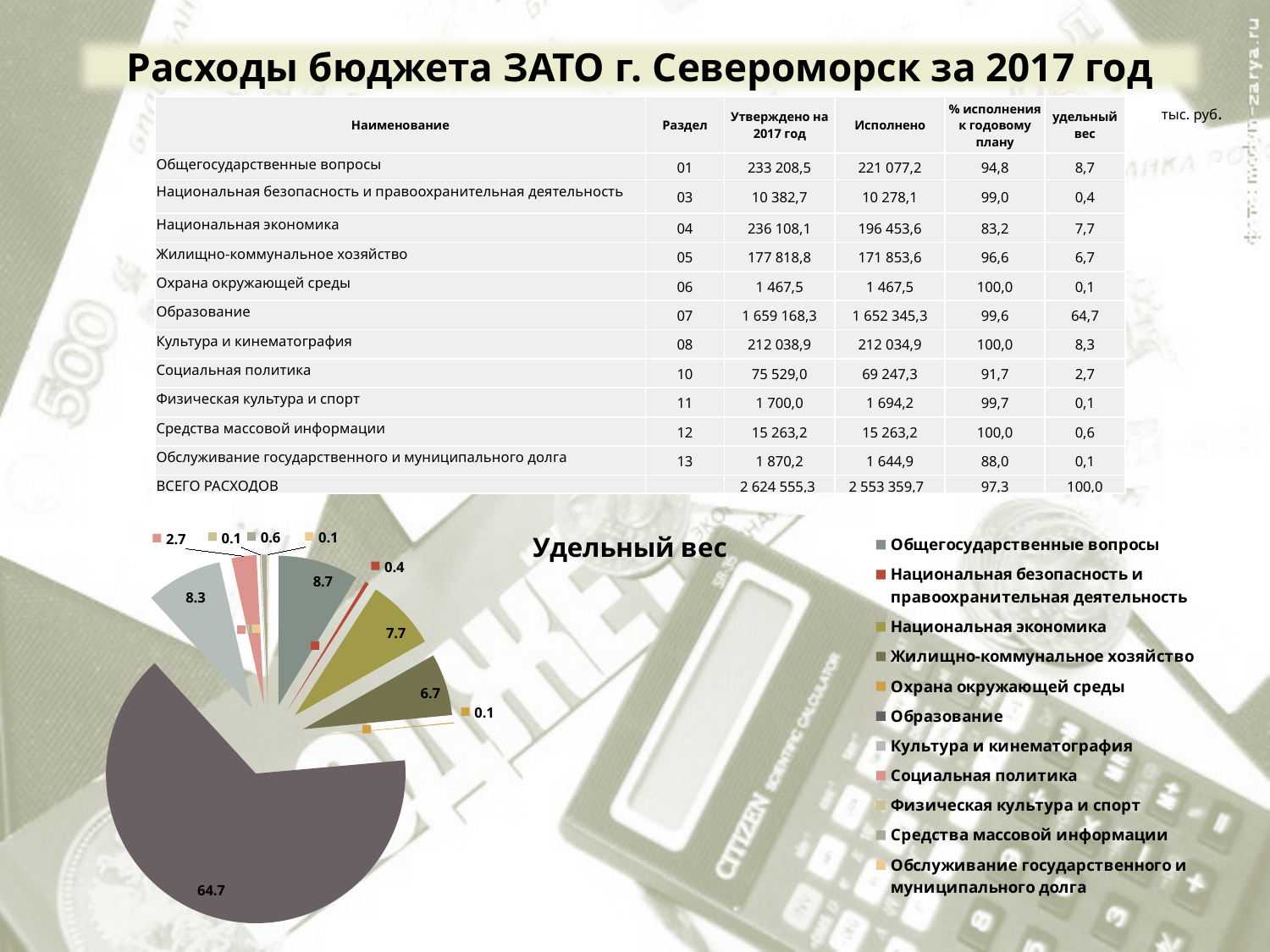
How many entries does the chart legend list? 11 What is the difference between the values for Образование and Общегосударственные вопросы in the pie chart? 56.0 Which is larger in the pie chart: Культура и кинематография or Национальная экономика? Культура и кинематография What value does the pie chart show for Жилищно-коммунальное хозяйство? 6.7 What is the title of the chart on the slide? Удельный вес What value does the pie chart show for Национальная экономика? 7.7 What kind of chart is shown on the slide? pie chart What value does the pie chart show for Общегосударственные вопросы? 8.7 What value is shown for the largest slice of the pie chart? 64.7 Which category has the largest slice in the pie chart? Образование What value does the pie chart show for Культура и кинематография? 8.3 What value does the pie chart show for Социальная политика? 2.7